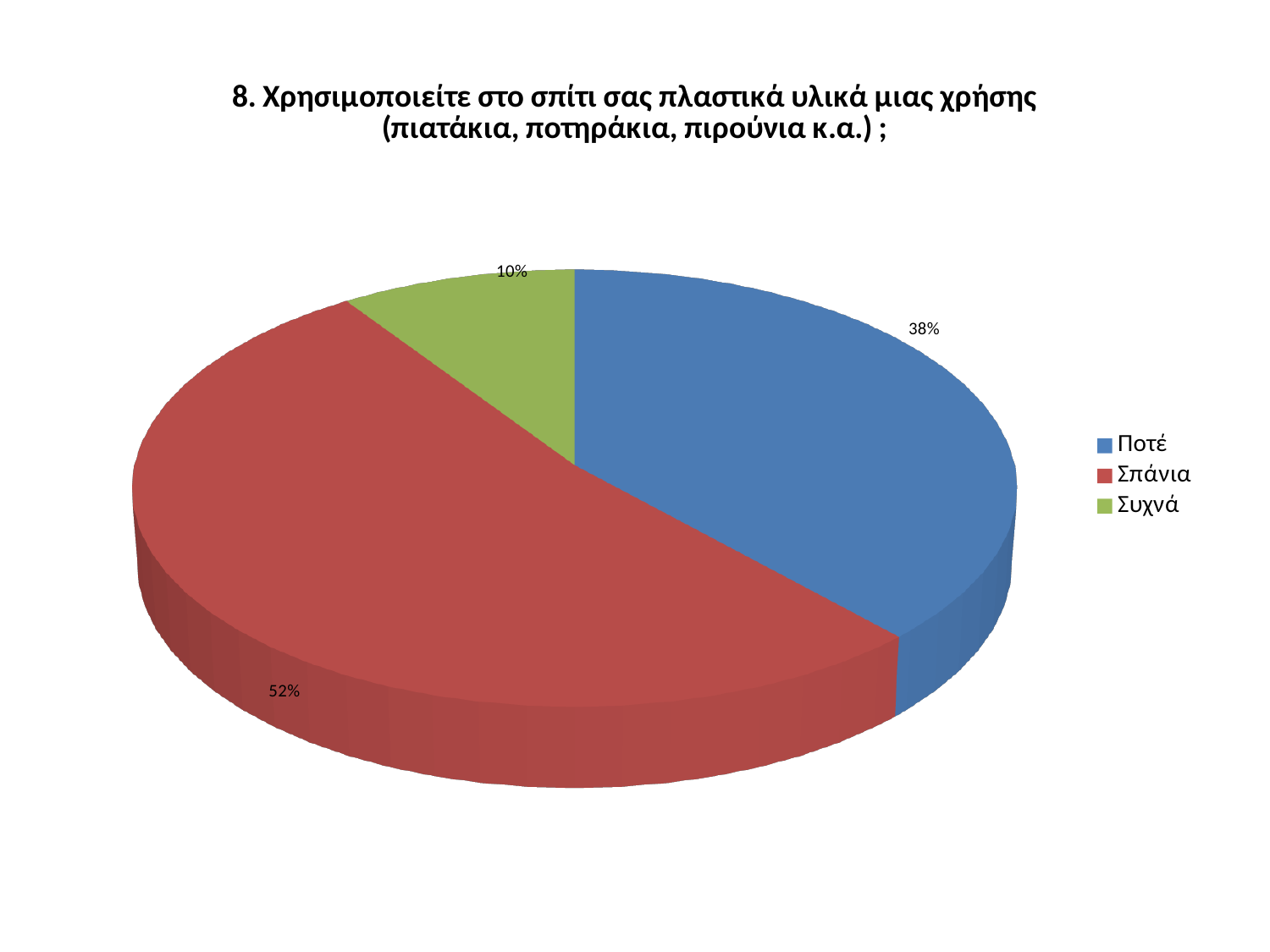
What share of the pie does Συχνά have? 10% How many categories does the pie chart have? 3 What share of the pie does Σπάνια have? 52% Which category is shown in blue in the legend? Ποτέ What share of the pie does Ποτέ have? 38% Which category has the smallest slice of the pie? Συχνά Which category has the largest slice of the pie? Σπάνια What colour is the slice for Συχνά? Green What kind of chart is shown on the slide? Pie chart What is the difference in percentage points between Ποτέ and Συχνά? 28 What is the difference in percentage points between Σπάνια and Ποτέ? 14 Which is larger, the slice for Ποτέ or the slice for Σπάνια? Σπάνια